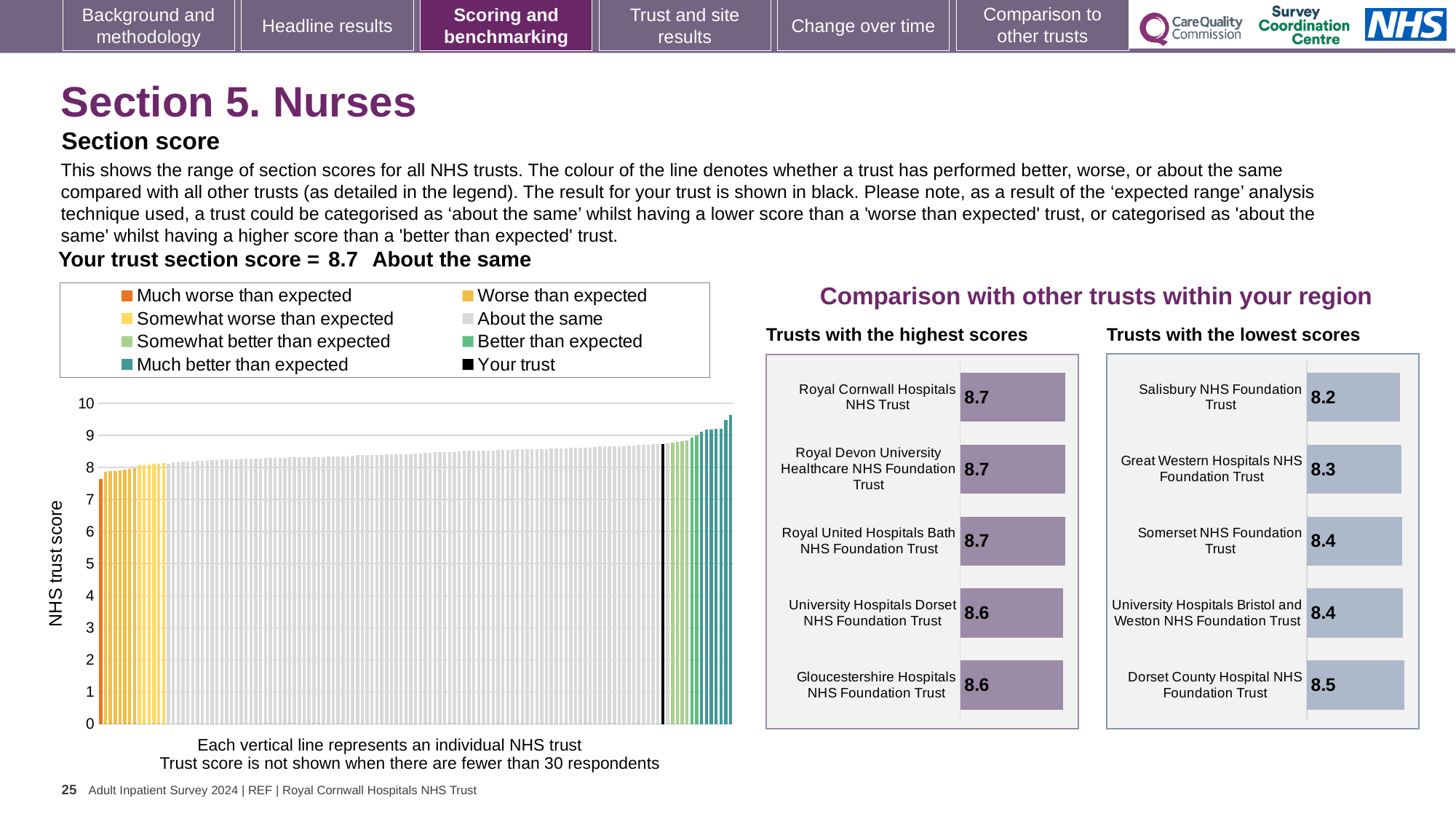
What is the section score for your trust shown on the slide? 8.7 In the 'Trusts with the lowest scores' chart, what is the difference between the scores of Dorset County Hospital NHS Foundation Trust and Salisbury NHS Foundation Trust? 0.3 In the 'Trusts with the highest scores' chart, what is the score for University Hospitals Dorset NHS Foundation Trust? 8.6 In the large chart on the left, is the value of the leftmost (orange) bar greater or less than 8? less In the large chart on the left, do the bar values rise or fall from left to right? rise In the 'Trusts with the lowest scores' chart, which trust has the highest score? Dorset County Hospital NHS Foundation Trust In the 'Trusts with the lowest scores' chart, which has the larger score: Great Western Hospitals NHS Foundation Trust or Somerset NHS Foundation Trust? Somerset NHS Foundation Trust What kind of chart is the large chart on the left showing NHS trust scores? bar chart In the 'Trusts with the lowest scores' chart, which trust has the lowest score? Salisbury NHS Foundation Trust How many entries does the legend of the large chart on the left list? 8 In the large chart on the left, is the value of the rightmost bar greater or less than 9? greater How many trusts are listed in the 'Trusts with the highest scores' chart? 5